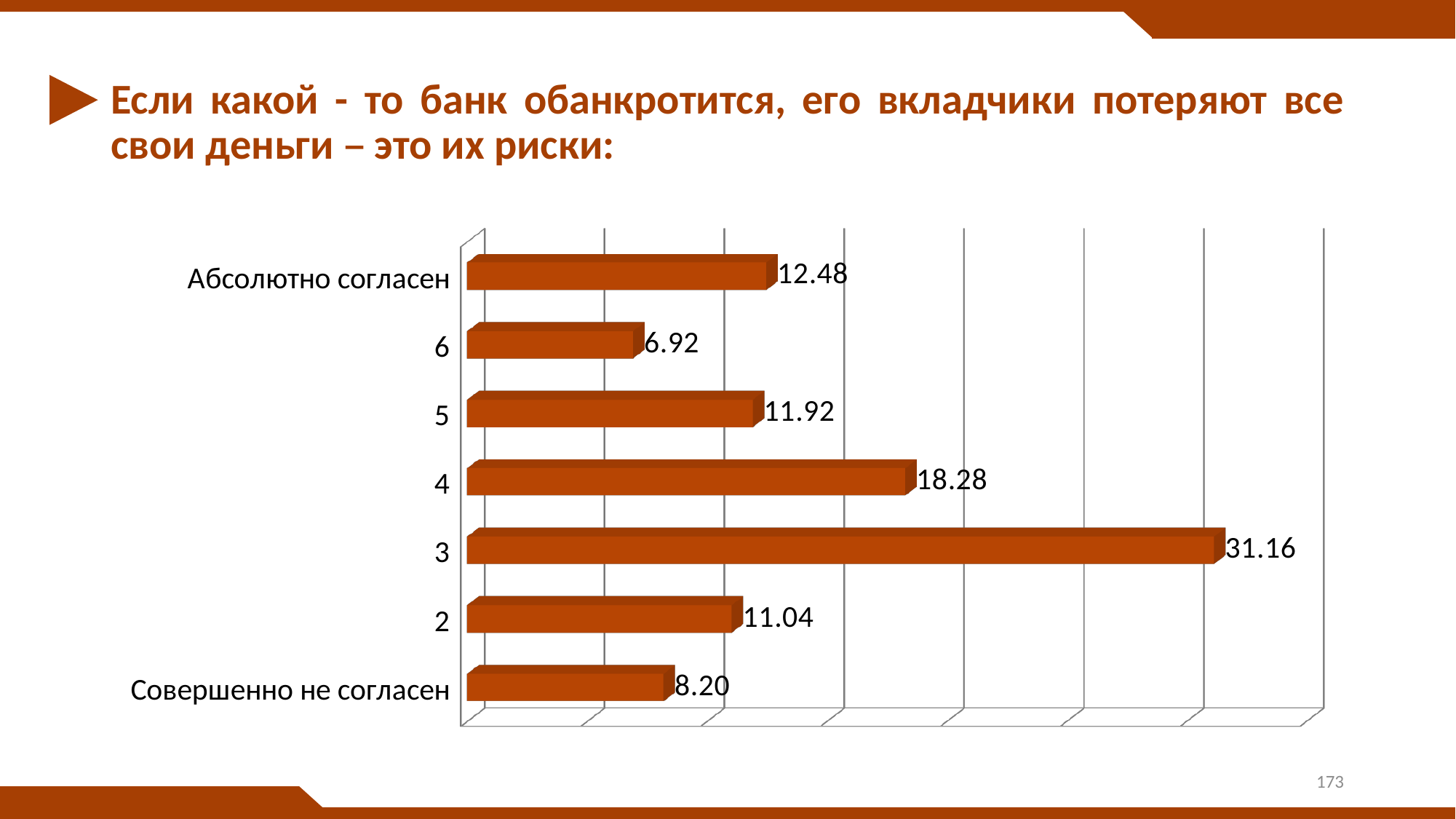
What is the difference between the values for "Абсолютно согласен" and "Совершенно не согласен"? 4.28 Which category has the highest value? 3 What is the value for "Абсолютно согласен"? 12.48 What is the value for category 3? 31.16 What is the value for category 6? 6.92 What is the value for "Совершенно не согласен"? 8.20 Which is larger, the value for category 5 or the value for category 2? 5 What is the difference between the values for category 3 and category 4? 12.88 How many categories are shown in the chart? 7 What kind of chart is shown on the slide? Bar chart What colour are the bars in the chart? Orange-brown Which category has the lowest value? 6